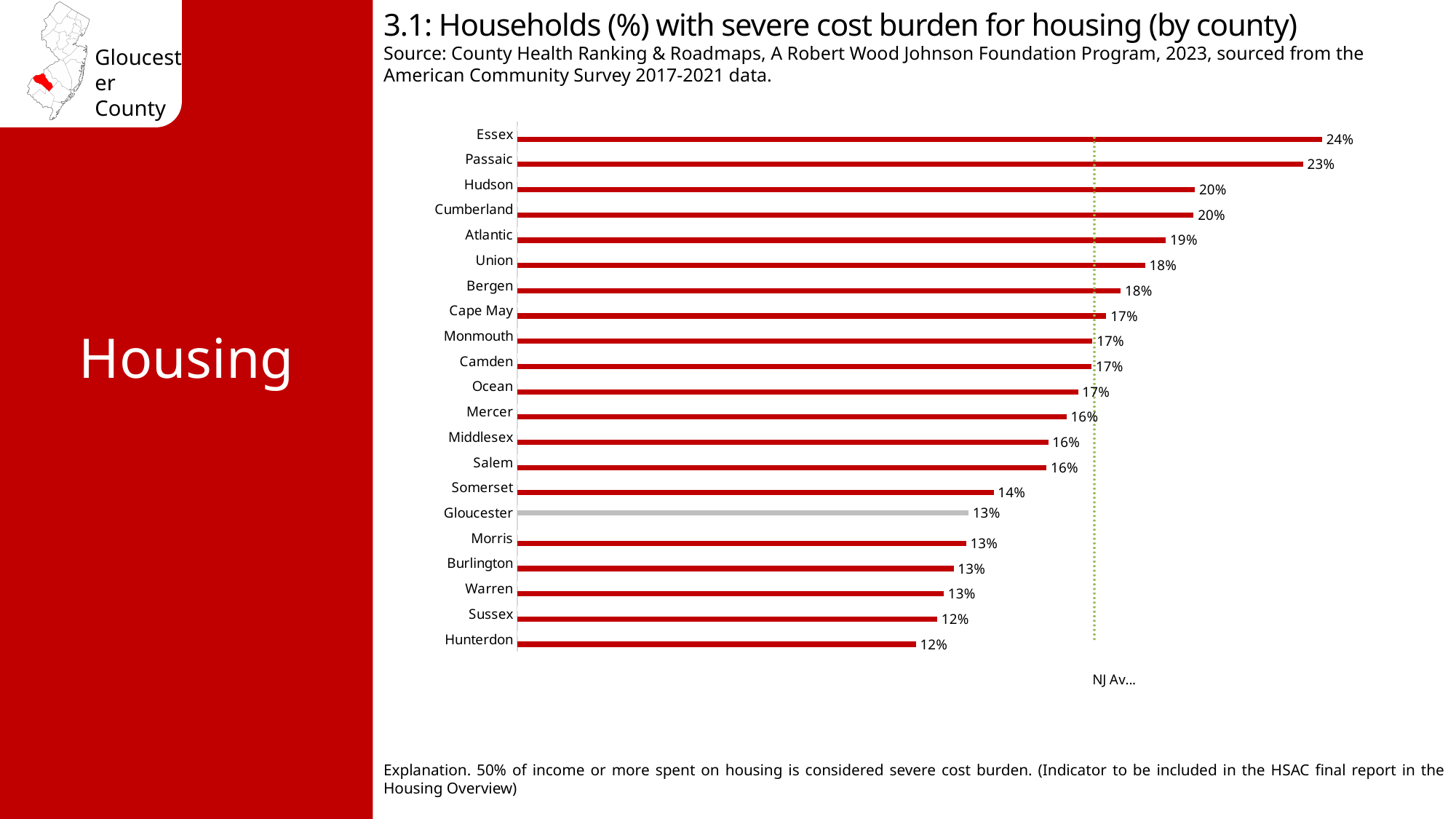
Which has a larger value, Passaic or Hunterdon? Passaic What is the value for Cumberland? 20% What is the value for Gloucester? 13% Which county's bar is shown in grey instead of red? Gloucester How many counties are shown in the chart? 21 What is the value for Essex? 24% Do the values increase or decrease going from the top county to the bottom county? Decrease Which county has the highest value? Essex What is the difference between the values for Essex and Gloucester? 11 percentage points What is the value for Somerset? 14% What is the value for Atlantic? 19% What kind of chart is this? Bar chart